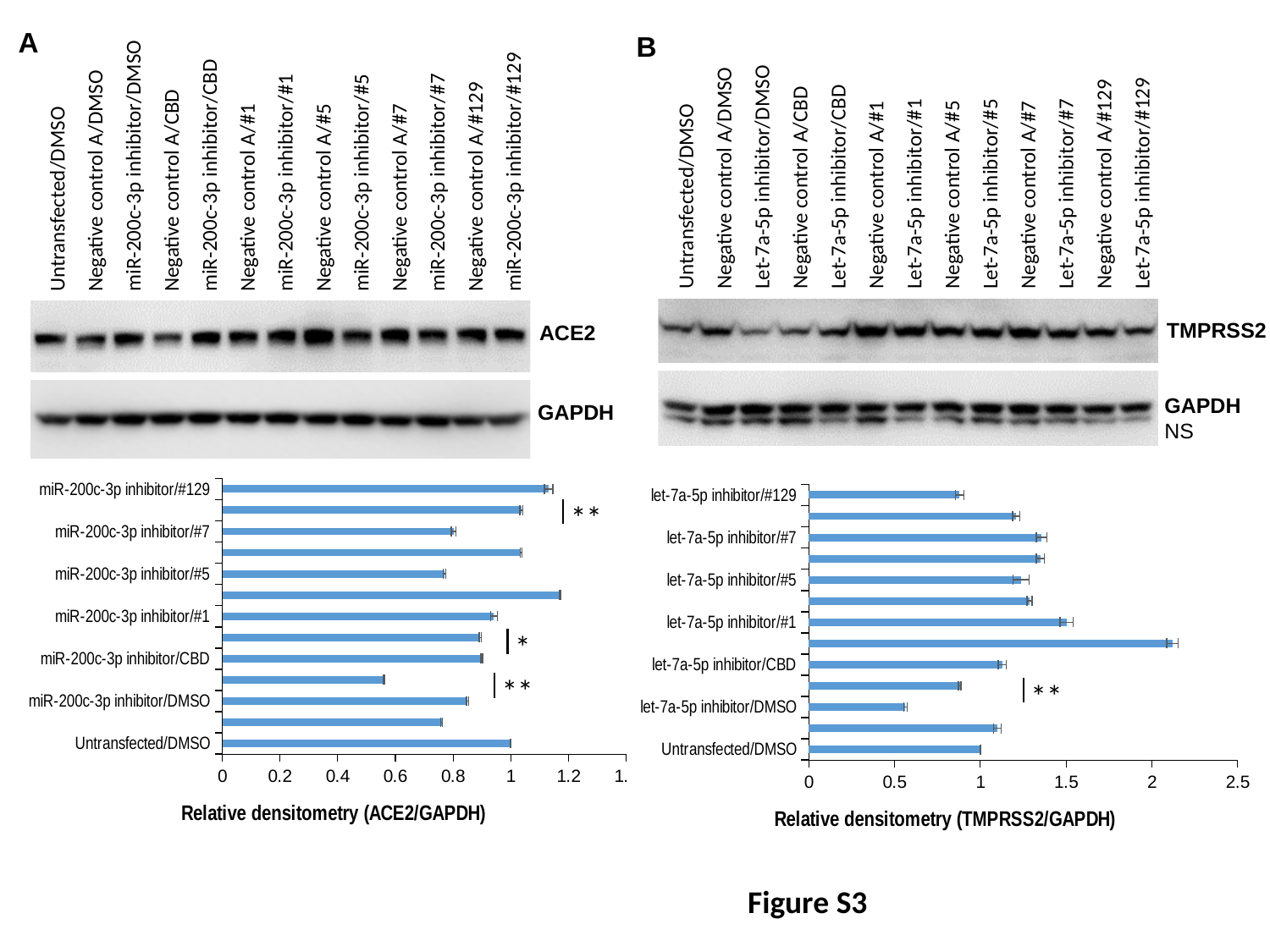
What kind of chart is shown in panel A? bar chart How many bars are plotted in the panel B chart (TMPRSS2/GAPDH)? 13 In the panel A chart (ACE2/GAPDH), what is the value for Untransfected/DMSO? 1 In the panel B chart (TMPRSS2/GAPDH), which labelled category has the lowest value? let-7a-5p inhibitor/DMSO In the panel A chart (ACE2/GAPDH), which is larger: miR-200c-3p inhibitor/#129 or miR-200c-3p inhibitor/#7? miR-200c-3p inhibitor/#129 What is the x-axis title of the panel A chart? Relative densitometry (ACE2/GAPDH) In the panel A chart (ACE2/GAPDH), is the value for miR-200c-3p inhibitor/#7 greater or less than 1? less In the panel B chart (TMPRSS2/GAPDH), is the value for let-7a-5p inhibitor/DMSO greater or less than 1? less In the panel A chart (ACE2/GAPDH), is the value for miR-200c-3p inhibitor/#129 greater or less than 1? greater In the panel B chart (TMPRSS2/GAPDH), what is the value for Untransfected/DMSO? 1 In the panel B chart (TMPRSS2/GAPDH), which is larger: let-7a-5p inhibitor/#7 or let-7a-5p inhibitor/#129? let-7a-5p inhibitor/#7